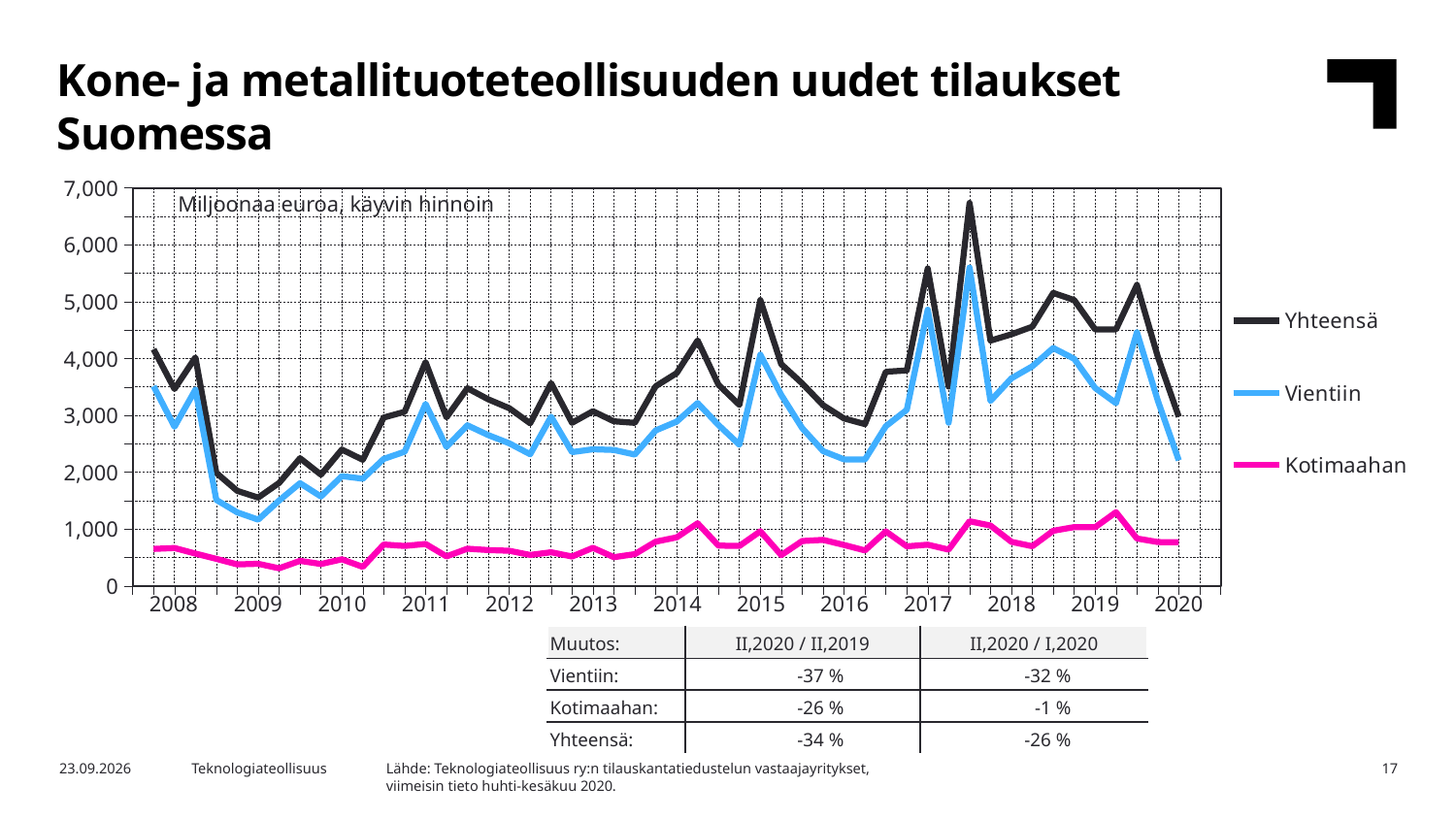
What unit is stated in the text inside the chart area? Miljoonaa euroa, käyvin hinnoin Which series has the lowest values throughout the chart? Kotimaahan How many years are labelled on the x axis? 13 Which series has the highest values throughout the chart? Yhteensä What are the three series named in the legend? Yhteensä, Vientiin, Kotimaahan Is the peak value of the Yhteensä series in 2017 greater or less than 6,000? greater Is the Kotimaahan series ever greater or less than 2,000 across the whole chart? less Is the last plotted value of the Vientiin series in 2020 greater or less than 3,000? less How many series does the legend list? 3 Which series is larger in 2015, Vientiin or Kotimaahan? Vientiin Does the Yhteensä series rise or fall from its 2017 peak to the end of 2020? fall What kind of chart is shown on the slide? line chart